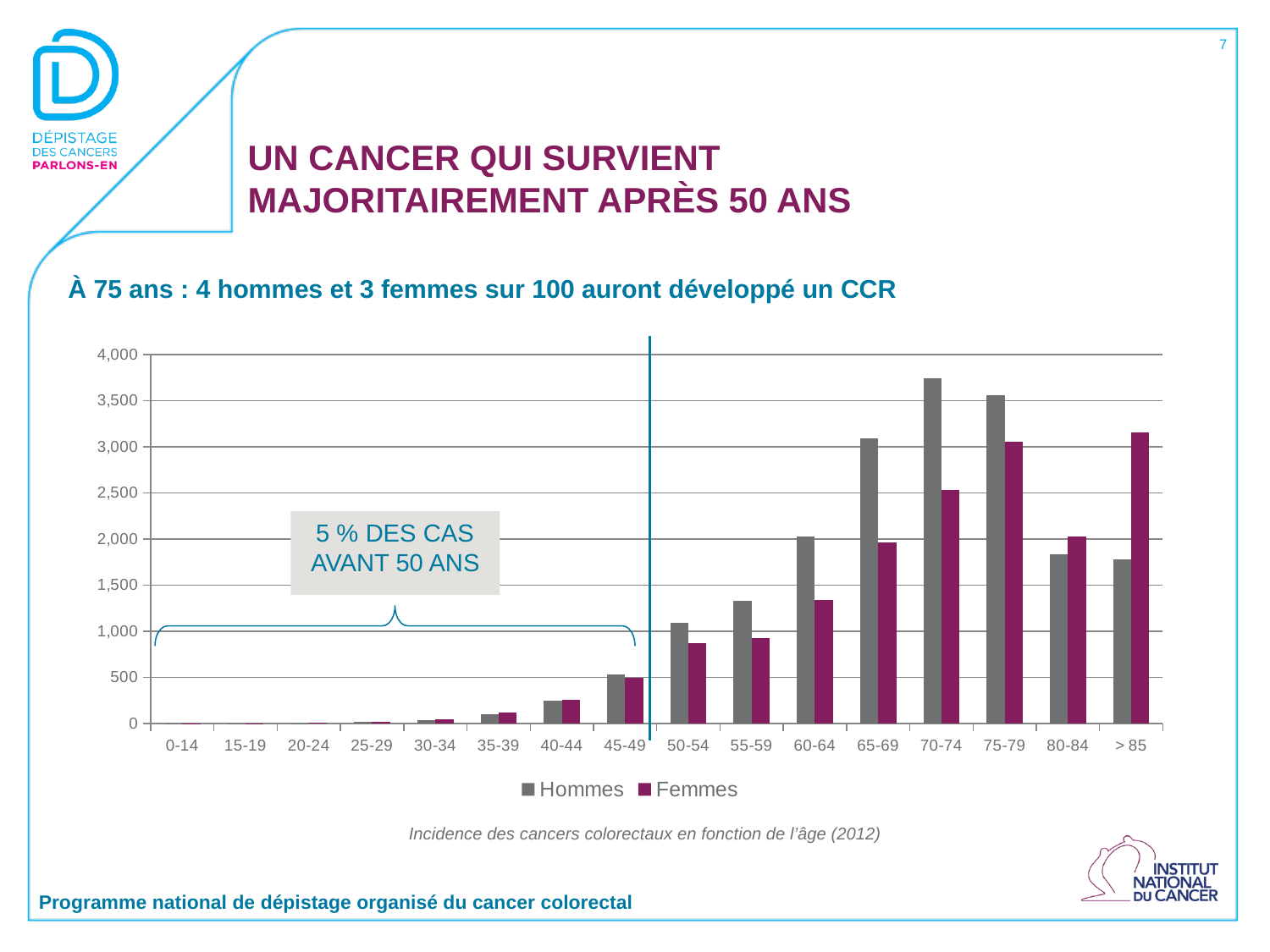
How many age categories are shown on the x axis of the chart? 16 Do the Hommes values rise or fall from the 0-14 category to the 70-74 category? rise For which age category is the Hommes value highest? 70-74 How many series does the chart legend list? 2 Is the Femmes value for 60-64 greater or less than 1,000? greater Is the Hommes value for 70-74 greater or less than 3,500? greater Which is larger for the > 85 age group, Hommes or Femmes? Femmes Which series are listed in the chart legend? Hommes and Femmes What kind of chart is shown on the slide? bar chart Which is larger for the 70-74 age group, Hommes or Femmes? Hommes Is the Femmes value for 50-54 greater or less than 1,000? less